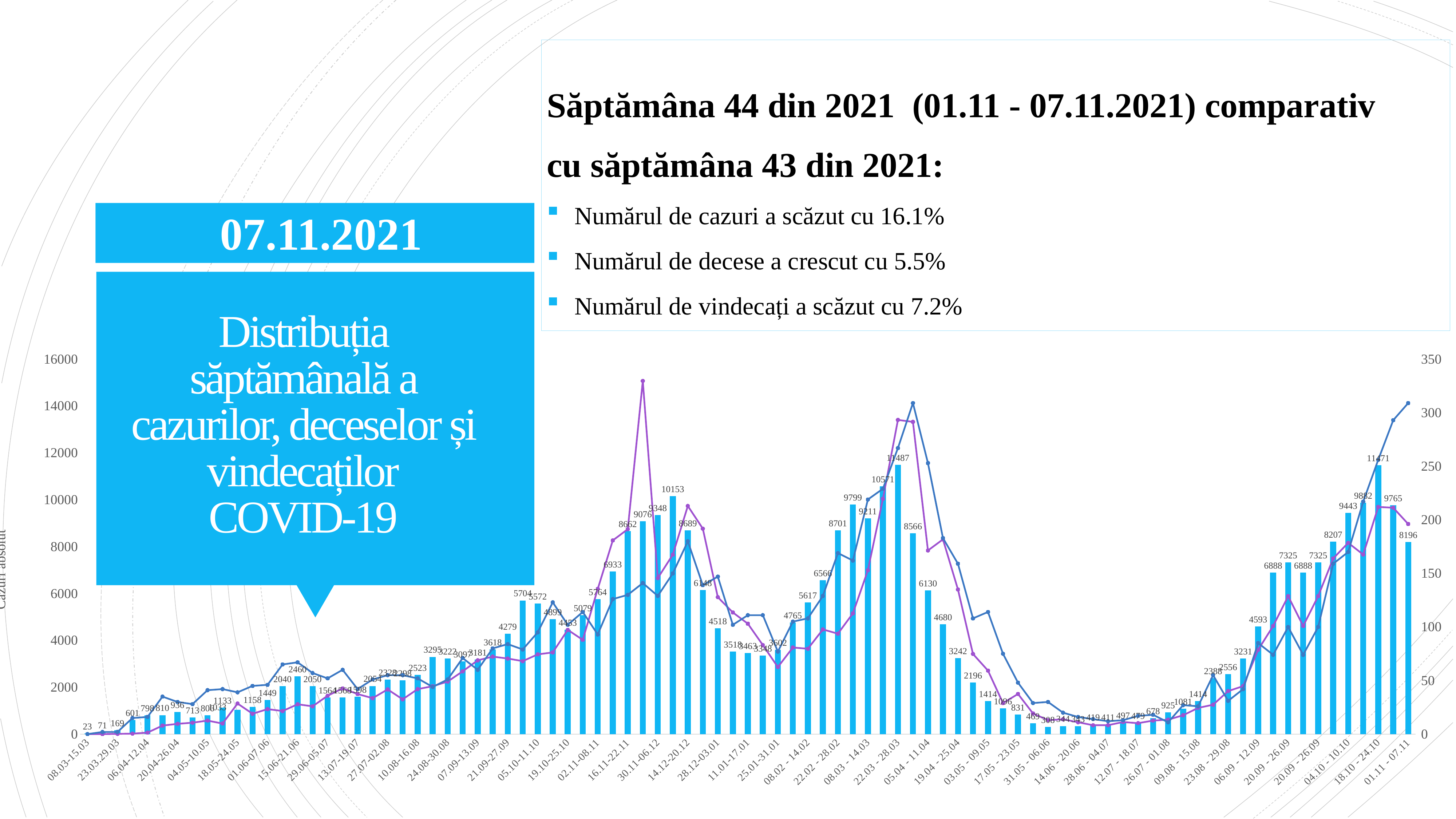
What is the value of the highest bar in the chart? 11487 What is the maximum value shown on the left vertical axis? 16000 What is the maximum value shown on the right vertical axis? 350 Is the value of the bar for 01.11 - 07.11 greater or less than 8000? greater Is the bar for 01.11 - 07.11 higher or lower than the bar immediately before it? Lower Do the bar values rise or fall over the last three weeks shown on the chart? Fall What is the value of the bar for the week 01.11 - 07.11? 8196 What kind of chart is shown on the slide? A combination bar and line chart What is the value of the bar for the first week, 08.03-15.03? 23 What is the value of the lowest bar in the chart? 23 What is the difference between the two rightmost bars (9765 and 8196)? 1569